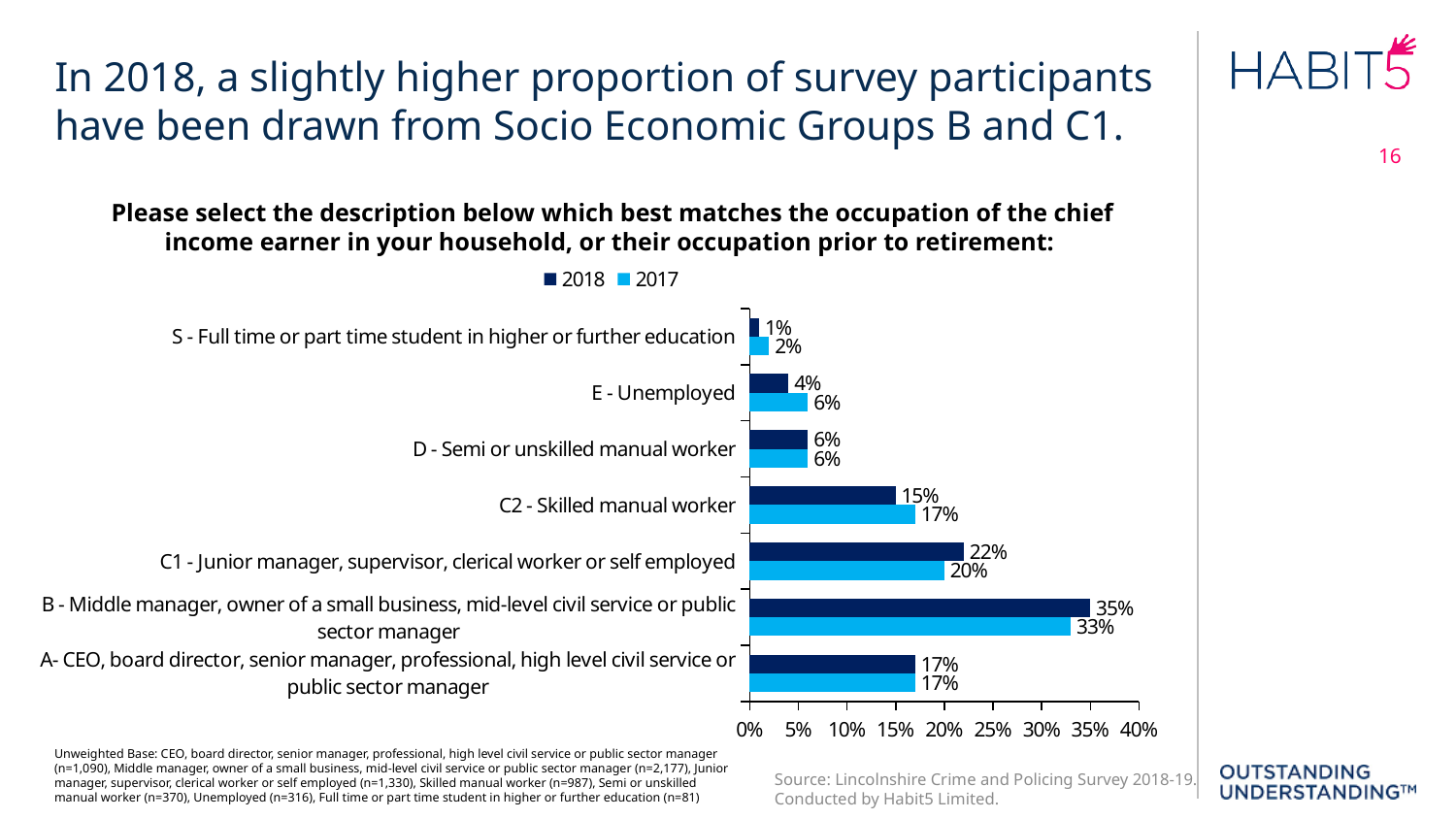
What is the difference between the 2018 and 2017 values for C2 - Skilled manual worker? 2% What was the 2018 value for E - Unemployed? 4% What type of chart is shown on the slide? Bar chart Which category has the lowest value in 2017? S - Full time or part time student in higher or further education Which category has the highest value in 2018? B - Middle manager, owner of a small business, mid-level civil service or public sector manager How many occupation categories are shown on the chart? 7 What was the 2017 value for C1 - Junior manager, supervisor, clerical worker or self employed? 20% For C1 - Junior manager, supervisor, clerical worker or self employed, which year has the larger value, 2018 or 2017? 2018 How many series does the legend list? 2 Is the 2017 value for B - Middle manager greater or less than 30%? greater What percentage of 2018 survey participants were in group B (Middle manager, owner of a small business, mid-level civil service or public sector manager)? 35% Which colour represents the 2017 series in the chart? Light blue